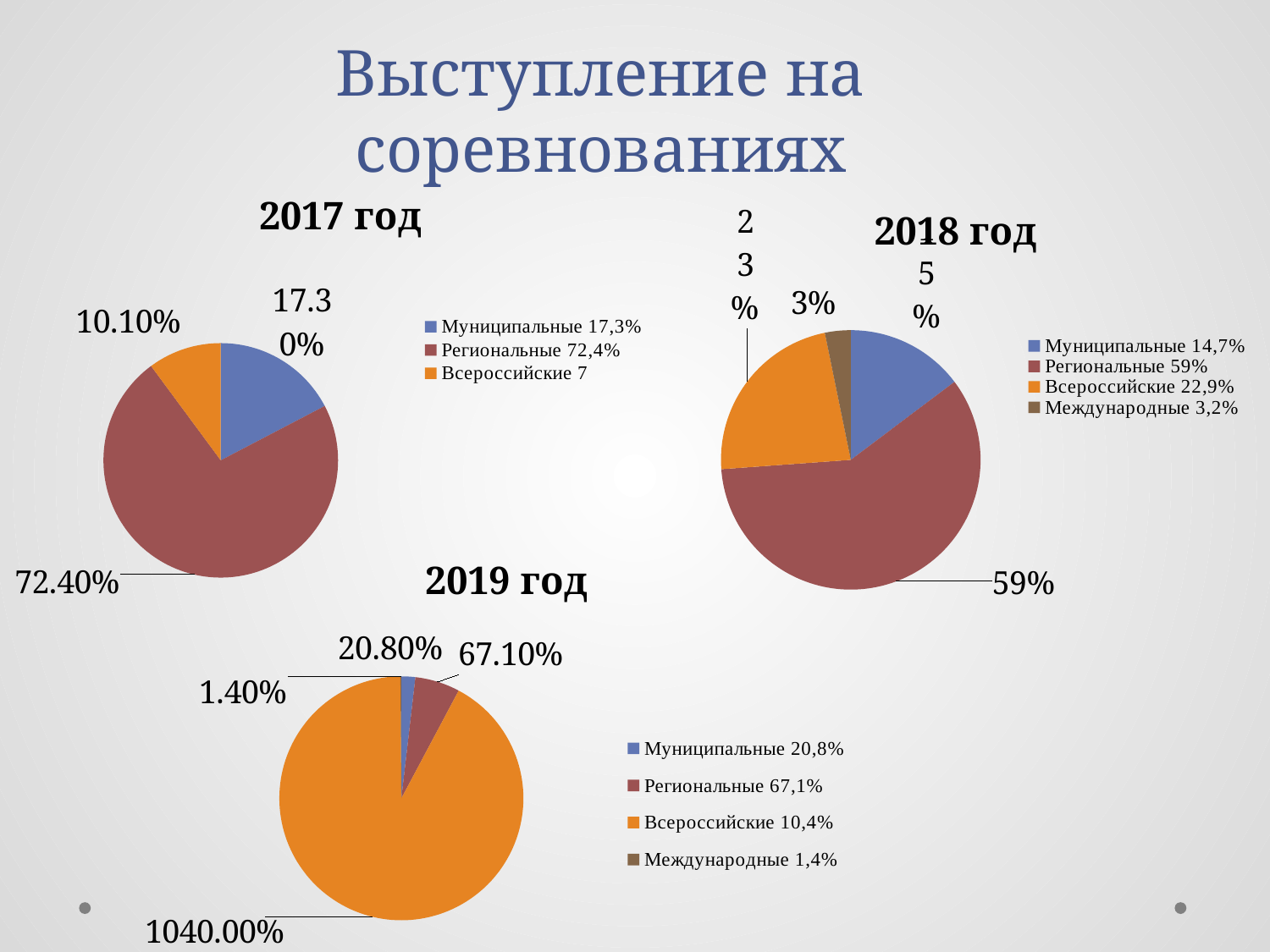
In the 2018 год chart, which category has the largest slice? Региональные How many entries does the legend of the 2019 год chart list? 4 In the 2017 год chart, what is the data label on the Региональные slice? 72.40% In the 2018 год chart, which category has the smallest slice? Международные How many slices does the 2017 год pie chart have? 3 In the 2017 год chart, which category has the largest slice? Региональные In the 2017 год chart, what is the data label on the Всероссийские slice? 10.10% In the 2018 год chart, what is the data label on the Региональные slice? 59% In the 2019 год chart, which colour is used for the largest slice? orange In the 2017 год chart, which category has the smallest slice? Всероссийские How many entries does the legend of the 2018 год chart list? 4 What kind of chart is used for the 2017 год chart? pie chart